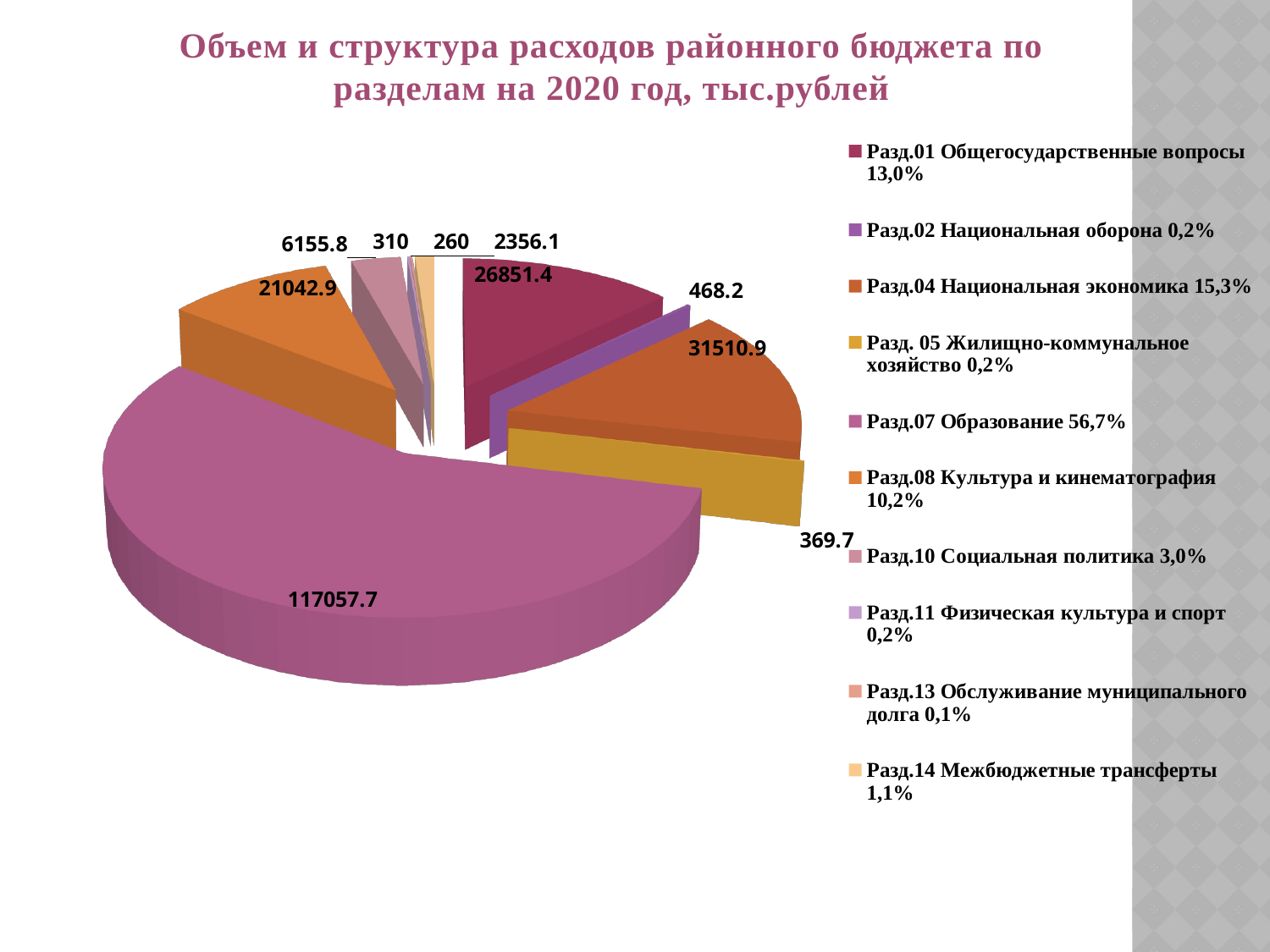
Which category has the smallest value? Разд.13 Обслуживание муниципального долга Which is larger, the value for Разд.08 Культура и кинематография or Разд.10 Социальная политика? Разд.08 Культура и кинематография What is the value for Разд.04 Национальная экономика? 31510.9 What is the value for Разд.01 Общегосударственные вопросы? 26851.4 What is the value for Разд.08 Культура и кинематография? 21042.9 Which category has the largest slice of the pie? Разд.07 Образование What is the difference between the values for Разд.04 Национальная экономика and Разд.01 Общегосударственные вопросы? 4659.5 What is the value for Разд.07 Образование? 117057.7 What share of the pie does Разд.07 Образование represent, according to the legend? 56,7% How many categories (slices) does the pie chart have? 10 What is the value for Разд.14 Межбюджетные трансферты? 2356.1 What kind of chart is shown on the slide? pie chart